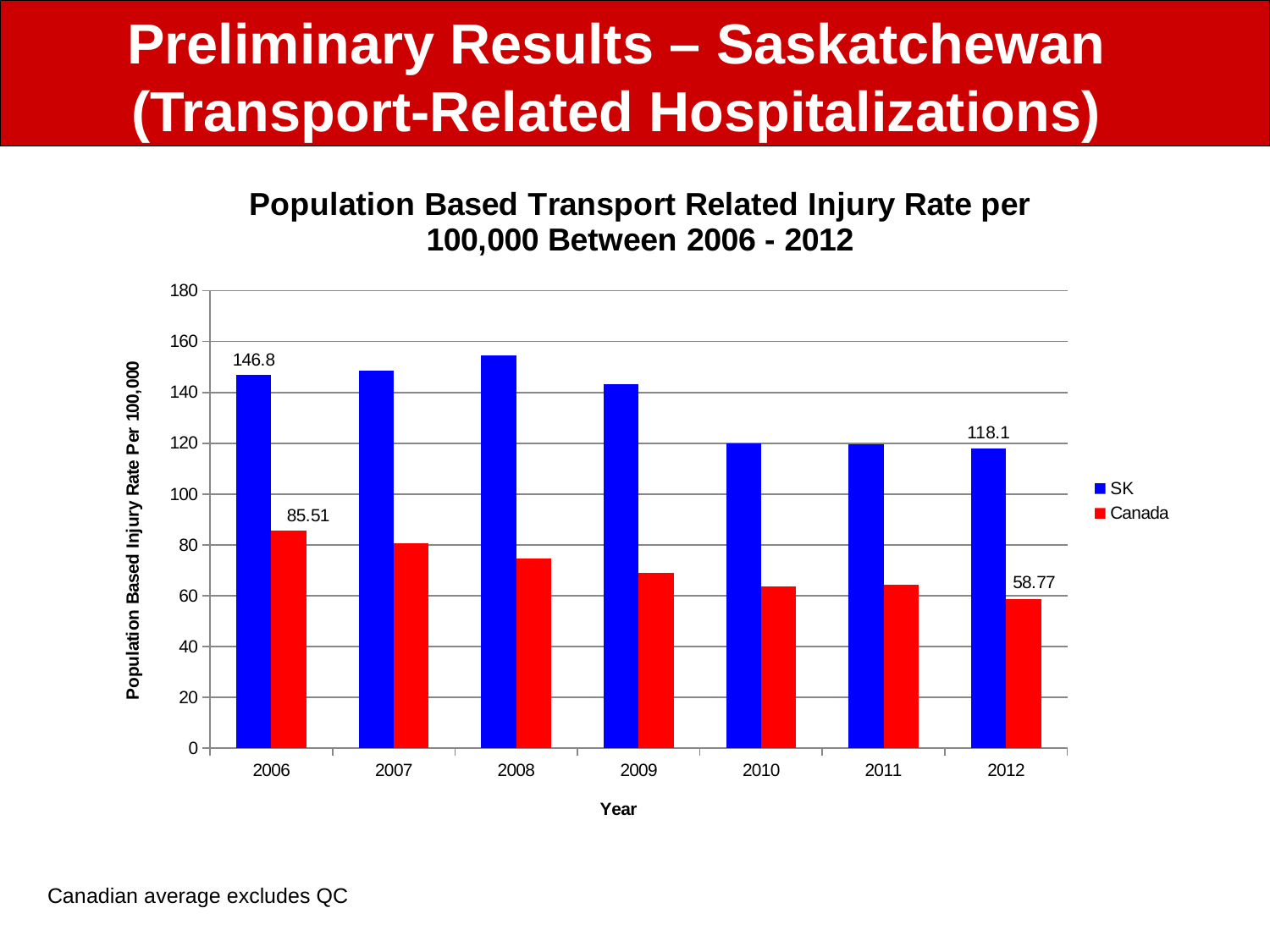
In which year is the SK value highest? 2008 What is the difference between the SK value in 2006 and the SK value in 2012? 28.7 In which year is the Canada value highest? 2006 Is the Canada value for 2009 greater or less than 80? less What is the SK value for 2012? 118.1 What is the SK value for 2006? 146.8 What is the Canada value for 2012? 58.77 What is the difference between the SK value and the Canada value in 2006? 61.29 What kind of chart is shown on the slide? bar chart Is the SK value for 2008 greater or less than 140? greater How many years are shown on the x axis? 7 How many series does the legend list? 2